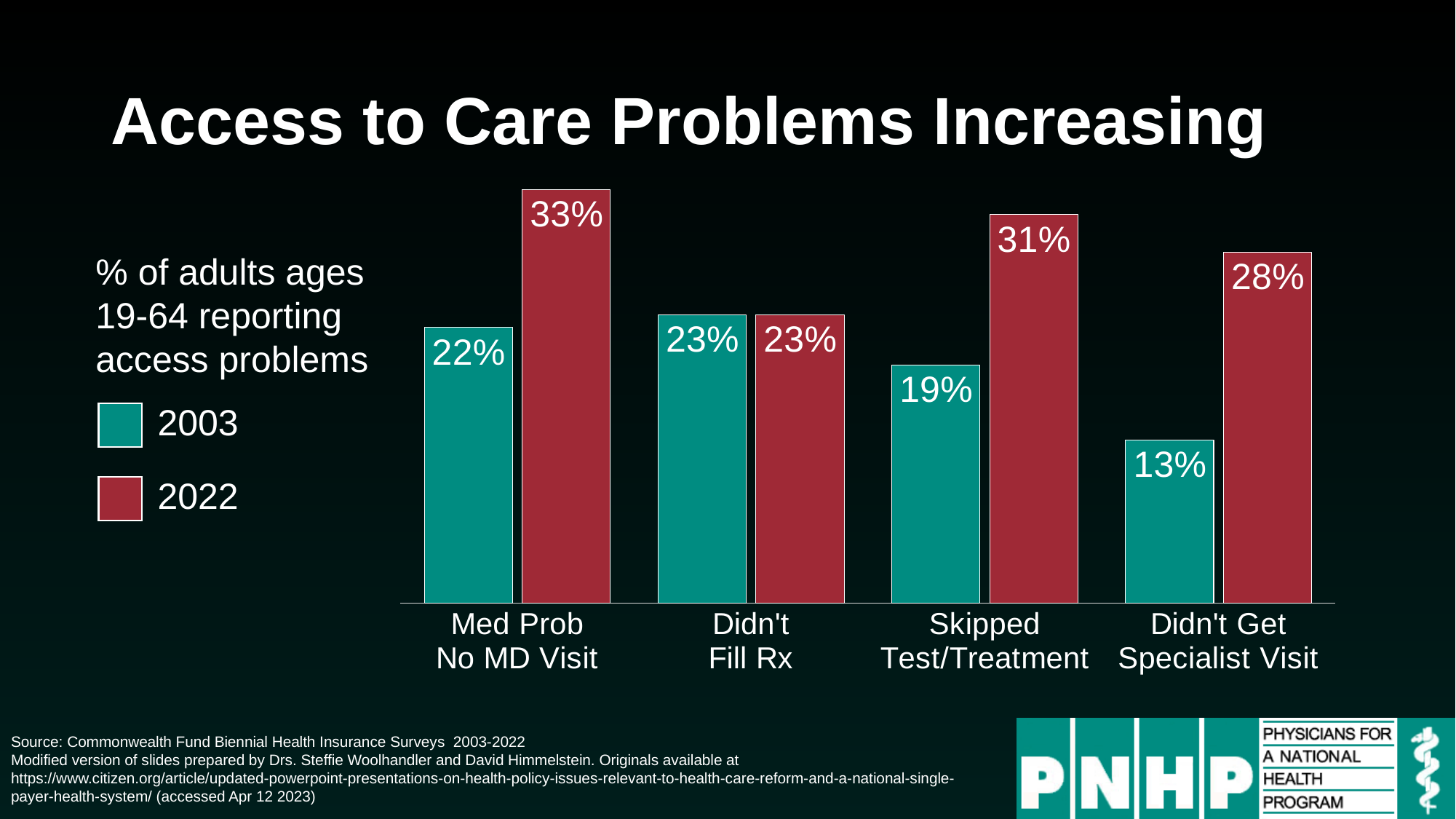
What is the difference between the 2022 and 2003 values for Skipped Test/Treatment? 12 What percentage skipped a test or treatment in 2003? 19% Which colour represents the 2022 series? Red Which category has the highest value for 2022? Med Prob No MD Visit What was the value for Didn't Get Specialist Visit in 2003? 13% What kind of chart is shown on the slide? Bar chart How many categories are shown on the x axis? 4 By how many percentage points did Didn't Get Specialist Visit increase from 2003 to 2022? 15 How many series does the legend list? 2 Which category has the lowest value for 2003? Didn't Get Specialist Visit Which is larger for Didn't Fill Rx, the 2003 value or the 2022 value? They are equal (23%) What percentage of adults reported a medical problem with no MD visit in 2022? 33%